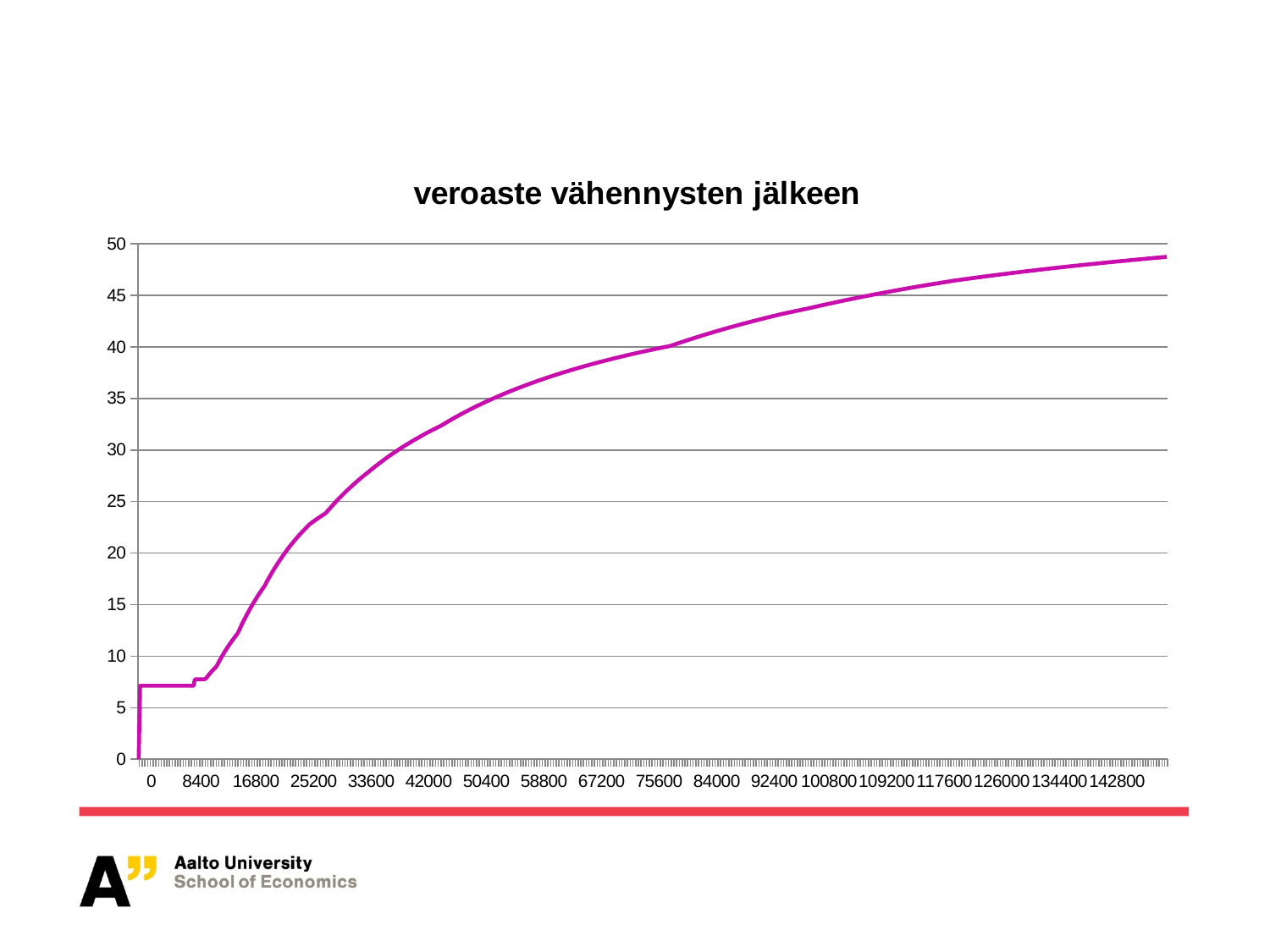
Do the values rise or fall as you move along the x axis from 0 to 142800? rise Is the value at x = 16800 greater or less than 10? greater Is the value at x = 142800 greater or less than 50? less What colour is the plotted line? magenta What kind of chart is shown on the slide? line chart What is the title of the chart? veroaste vähennysten jälkeen Is the value at x = 8400 greater or less than 10? less